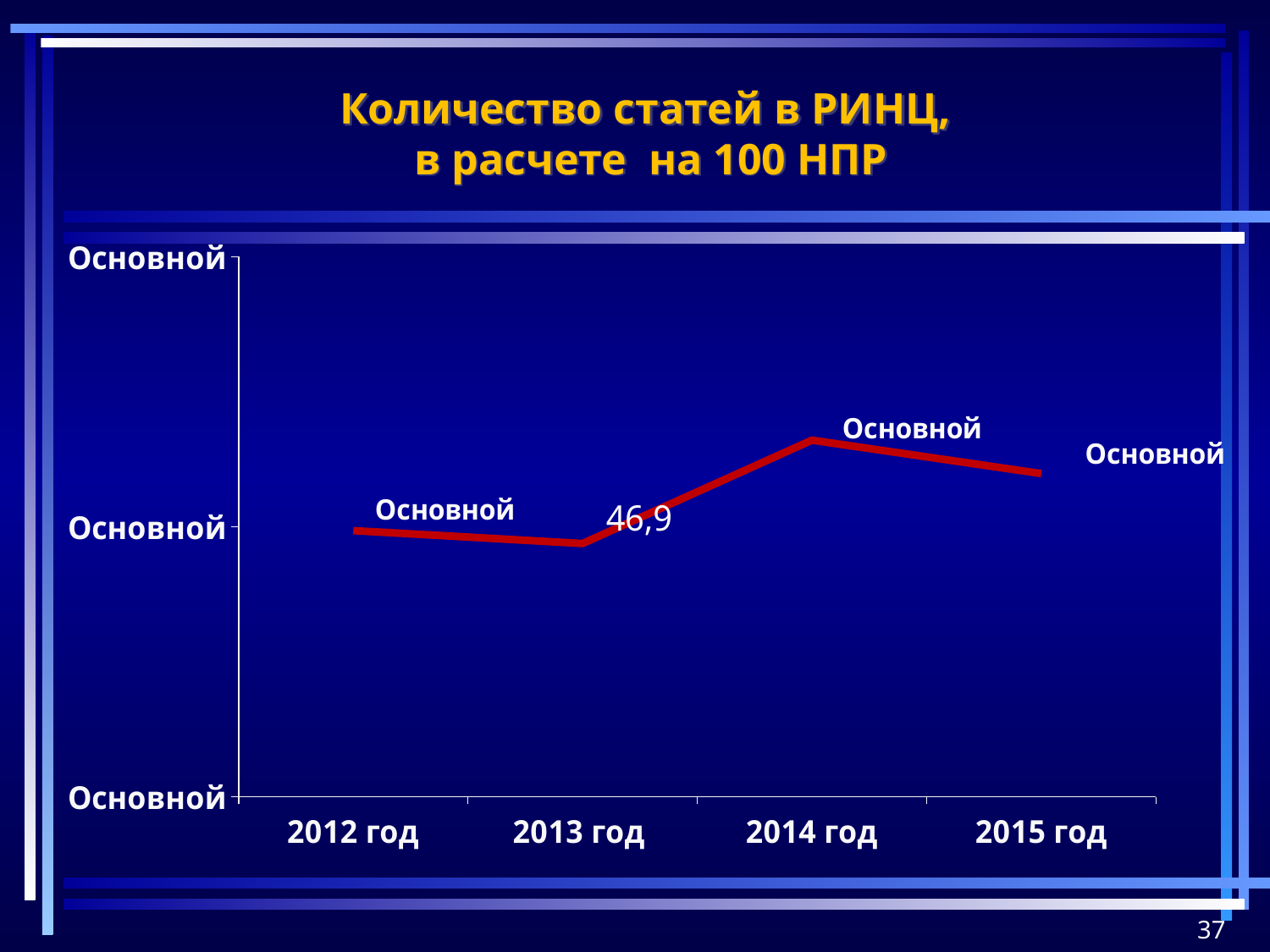
What value is labelled for 2013 год? 46,9 What colour is the plotted line? red Does the line rise or fall from 2014 год to 2015 год? fall Which year has the highest value on the line? 2014 год Which is larger, the value for 2014 год or the value for 2012 год? 2014 год What kind of chart is shown on the slide? line chart What is the title of the chart? Количество статей в РИНЦ, в расчете на 100 НПР Does the line rise or fall from 2013 год to 2014 год? rise Which year has the lowest value on the line? 2013 год Which is larger, the value for 2015 год or the value for 2013 год? 2015 год How many years are plotted along the x axis? 4 What is the first year shown on the x axis? 2012 год